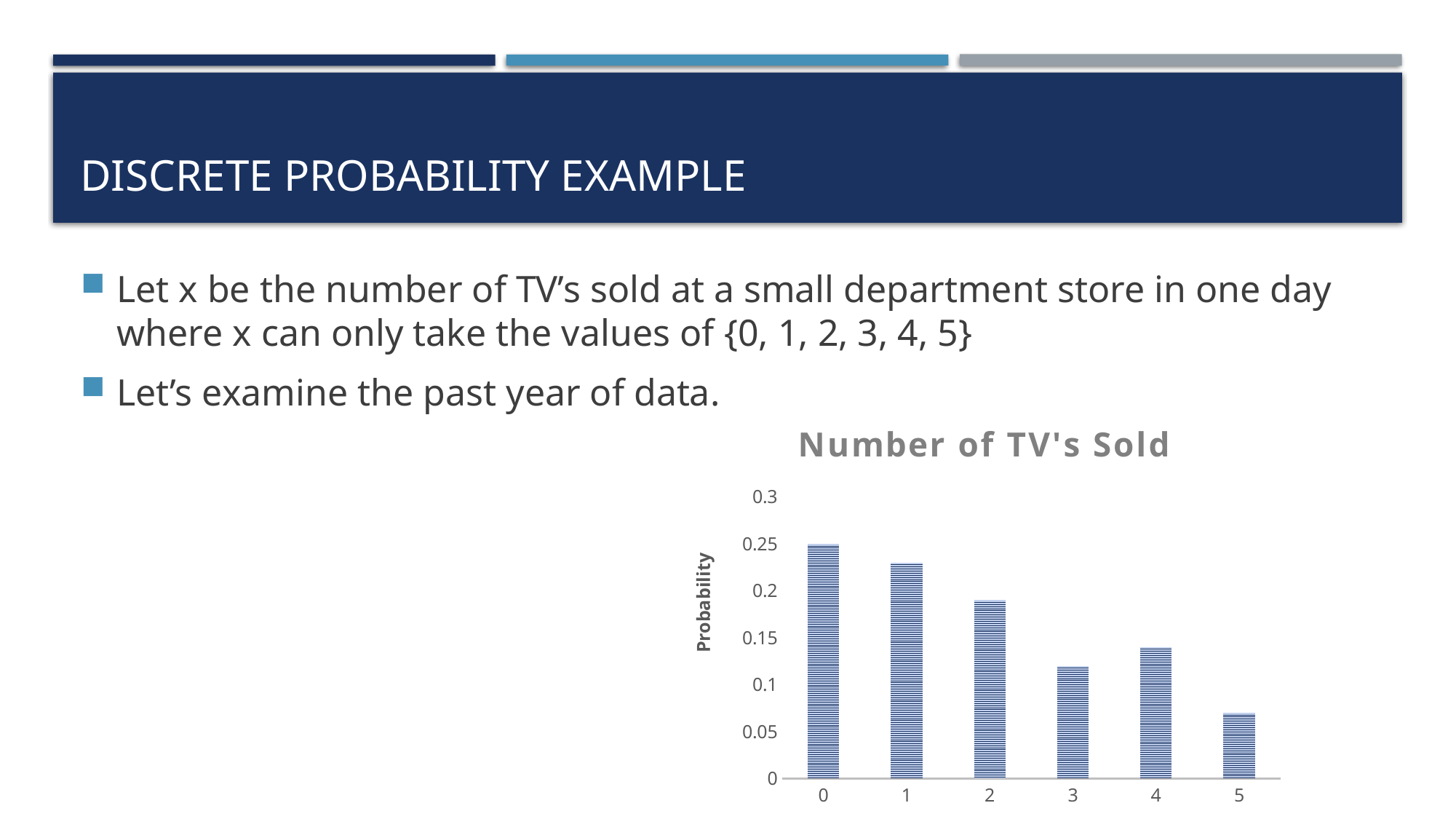
Is the probability for 1 TV sold greater or less than 0.2? greater Which number of TVs sold has the lowest probability? 5 Which number of TVs sold has the highest probability? 0 Is the probability for 5 TVs sold greater or less than 0.1? less What is the label on the vertical axis of the chart? Probability Which has a higher probability, 3 TVs sold or 4 TVs sold? 4 What is the title of the chart? Number of TV's Sold Which has a higher probability, 1 TV sold or 2 TVs sold? 1 Is the probability for 3 TVs sold greater or less than 0.15? less What is the probability for 0 TVs sold? 0.25 What kind of chart is shown on the slide? bar chart How many categories are plotted on the x axis of the chart? 6